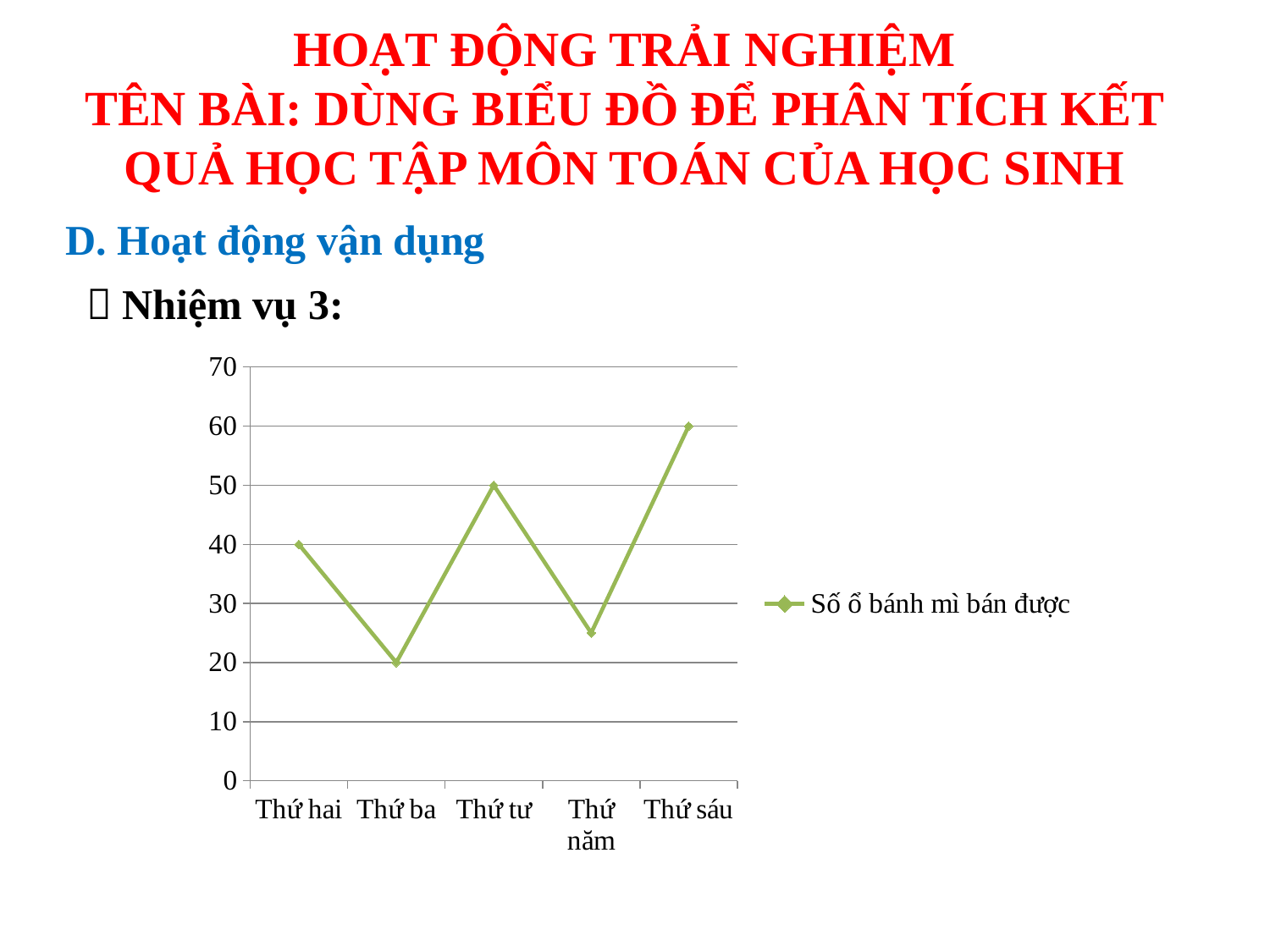
How many series does the chart's legend list? 1 Which day has the lowest value? Thứ ba What is the name of the series shown in the legend? Số ổ bánh mì bán được What kind of chart is shown on the slide? line chart What is the value for Thứ hai? 40 Is the value for Thứ năm greater or less than 30? less What is the value for Thứ sáu? 60 How many days are plotted on the x axis of the chart? 5 Which day has the highest value? Thứ sáu What is the difference between the values for Thứ sáu and Thứ ba? 40 What is the value for Thứ ba? 20 What is the value for Thứ tư? 50